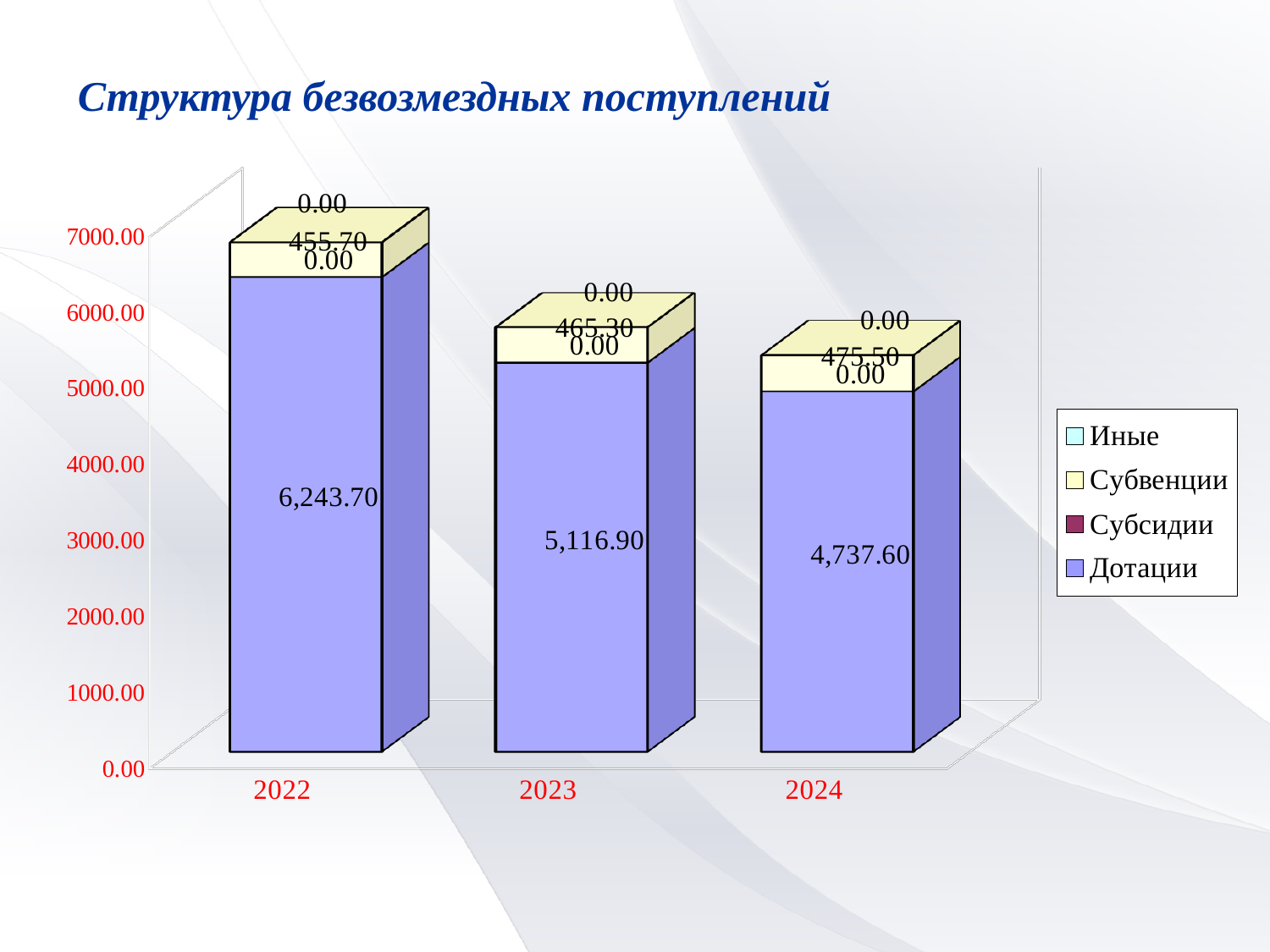
How many series does the legend list? 4 What is the value of Субвенции for 2024? 475.50 What is the value of Дотации for 2022? 6,243.70 Do the Дотации values rise or fall from 2022 to 2024? Fall Which year has the highest value of Дотации? 2022 What kind of chart is shown on the slide? Stacked bar chart What is the value of Дотации for 2023? 5,116.90 What is the difference between the Дотации values for 2022 and 2023? 1,126.80 How many years are shown on the x axis? 3 What is the total of the stacked bar for 2024? 5,213.10 Which year has the lowest value of Субвенции? 2022 Which is larger: Дотации in 2023 or Дотации in 2024? Дотации in 2023